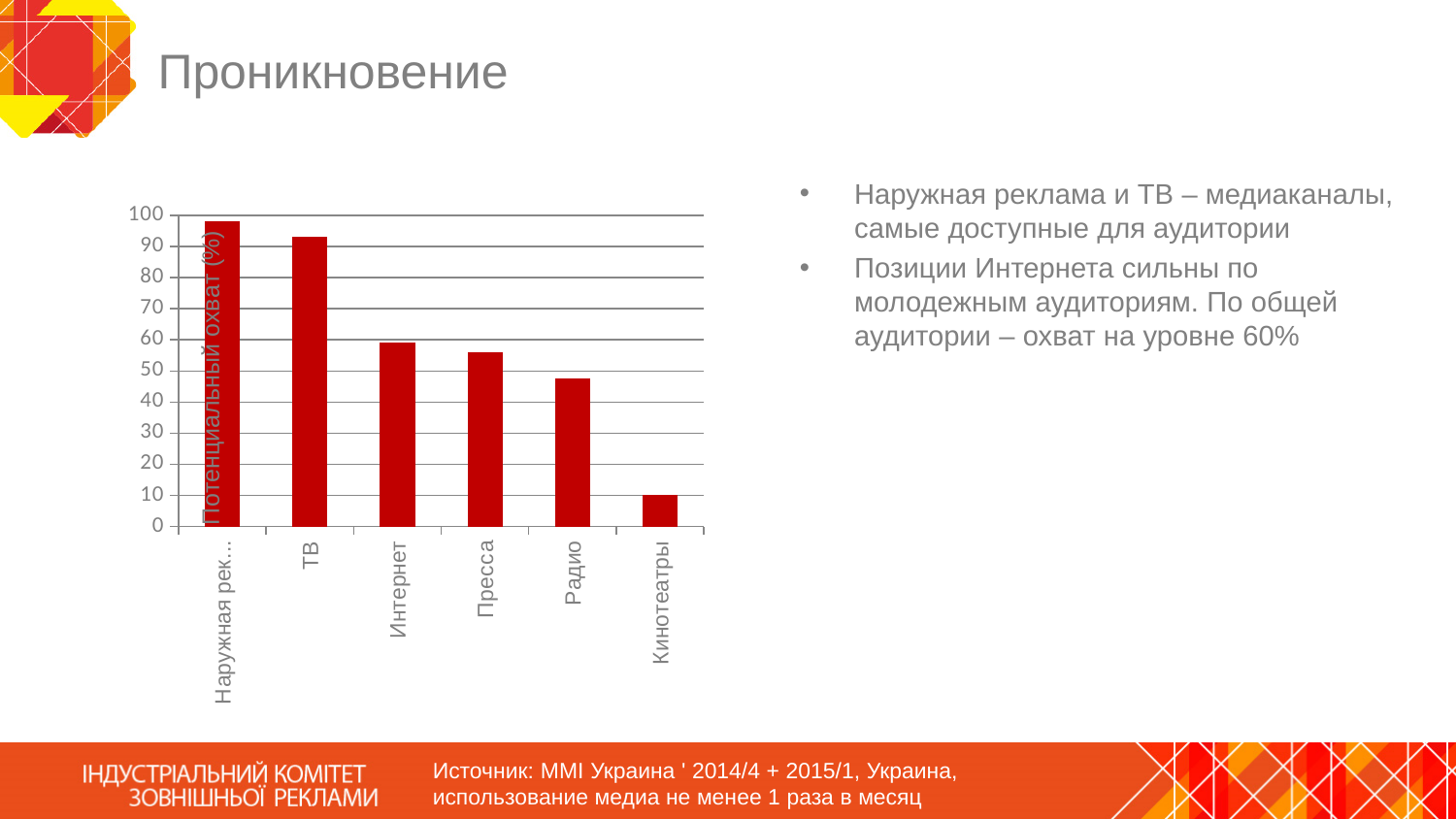
Do the bar values rise or fall from left to right across the categories? fall Which has a larger value, ТВ or Интернет? ТВ Is the value for Интернет greater or less than 50? greater Is the value for Пресса greater or less than 70? less Which category has the lowest value in the chart? Кинотеатры Is the value for Радио greater or less than 40? greater How many categories are plotted in the chart? 6 Which has a larger value, Пресса or Радио? Пресса Which category has the highest value in the chart? Наружная реклама What kind of chart is shown on the slide? bar chart